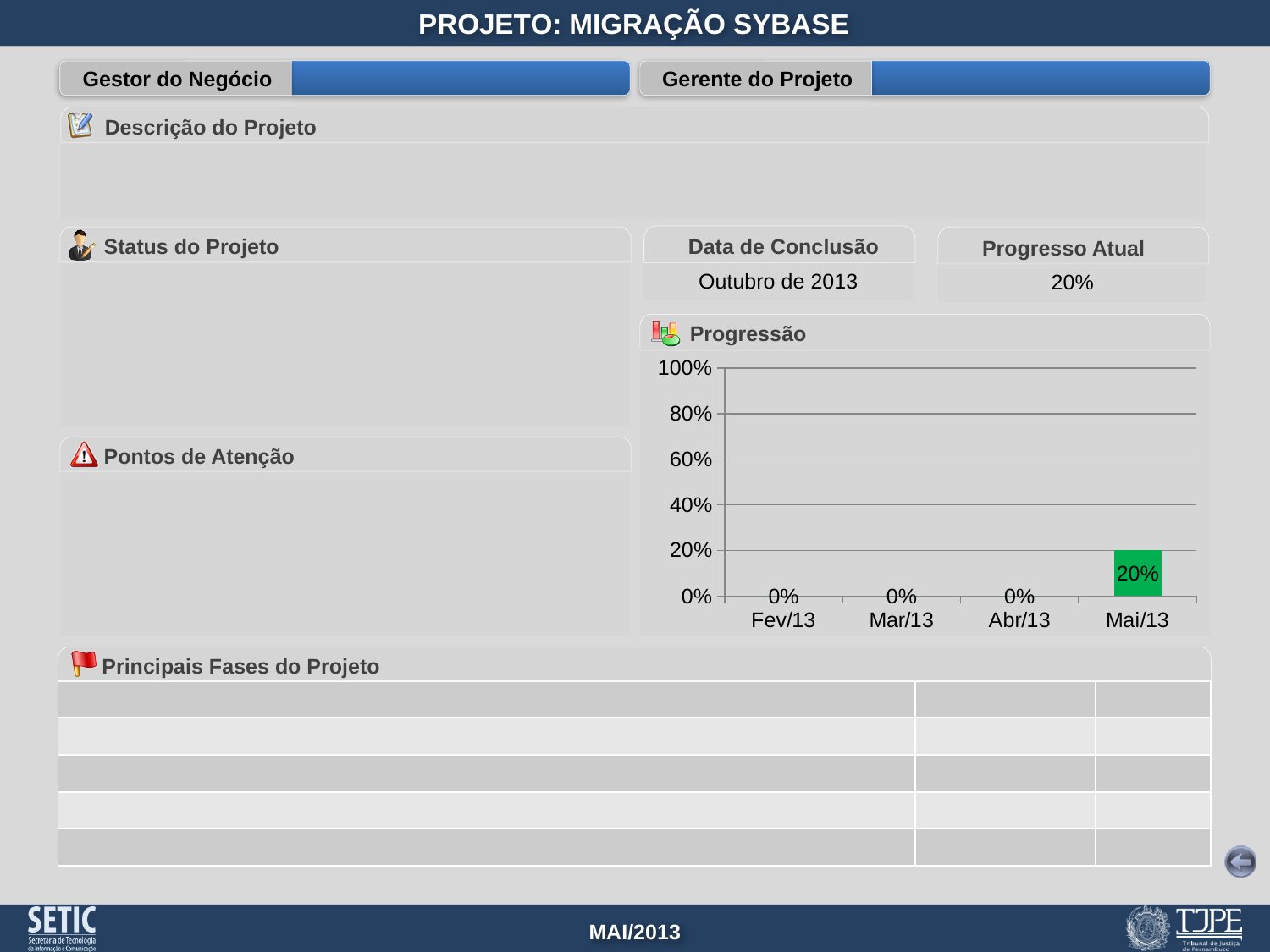
What is the title of the chart on the slide? Progressão What is the highest value shown on the y axis of the Progressão chart? 100% What kind of chart is the Progressão chart? bar chart What is the difference between the values for Mai/13 and Abr/13 in the Progressão chart? 20% Do the values in the Progressão chart rise or fall from Fev/13 to Mai/13? rise How many months are shown on the x axis of the Progressão chart? 4 What is the value for Abr/13 in the Progressão chart? 0% Which is larger in the Progressão chart, the value for Mar/13 or the value for Mai/13? Mai/13 Which month has the highest value in the Progressão chart? Mai/13 What is the value for Fev/13 in the Progressão chart? 0% Is the value for Mai/13 in the Progressão chart greater or less than 40%? less What is the value for Mai/13 in the Progressão chart? 20%